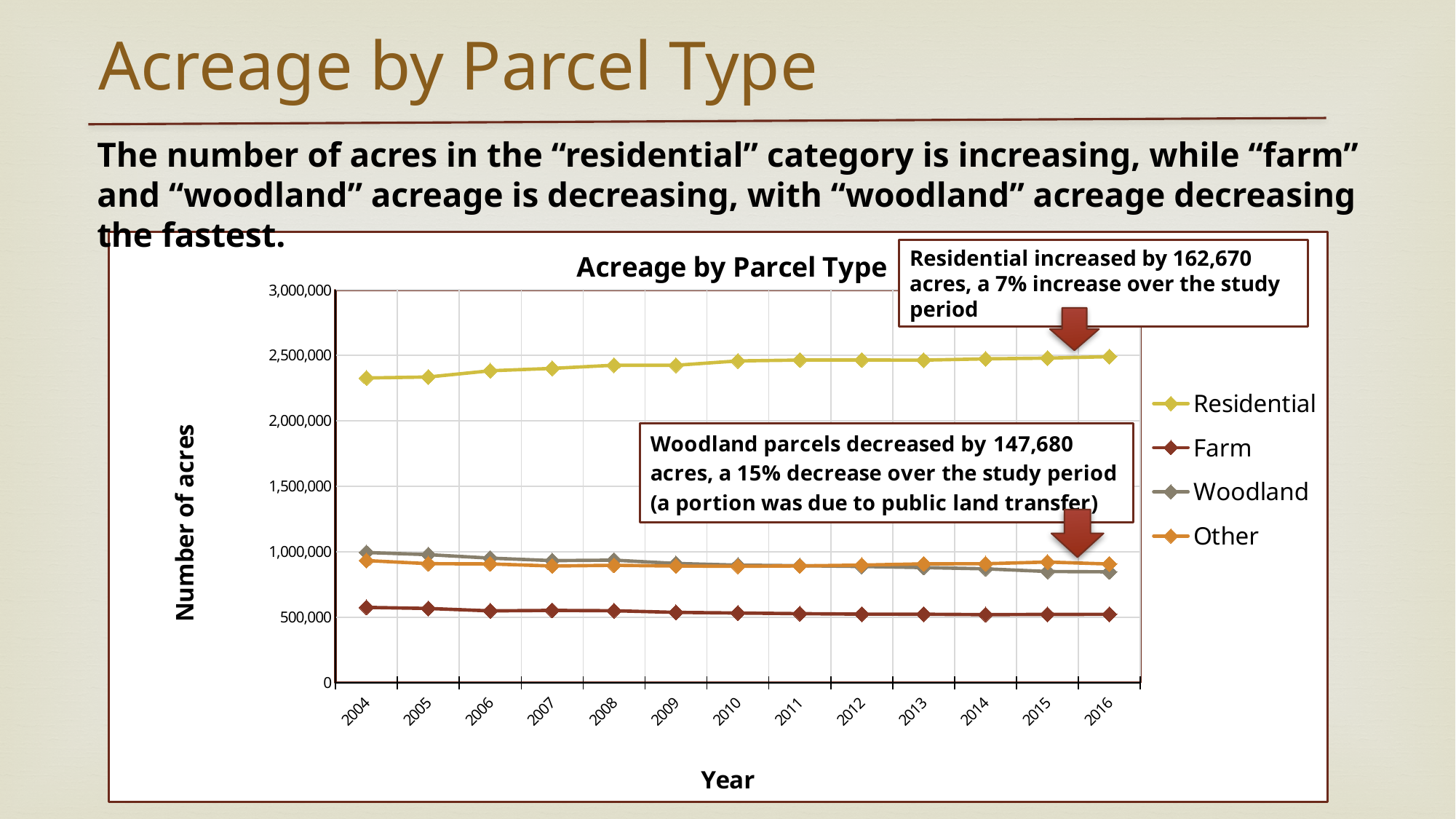
Is the value for Residential in 2004 greater or less than 2,000,000? greater In 2010, which is larger, the Woodland value or the Farm value? Woodland Is the value for Woodland in 2016 greater or less than 1,000,000? less Does the Woodland line rise or fall from 2004 to 2016? fall What kind of chart is shown on the slide? line chart Which parcel type has the lowest acreage throughout the chart? Farm How many series does the legend of the chart list? 4 Which parcel type has the highest acreage throughout the chart? Residential Does the Residential line rise or fall from 2004 to 2016? rise According to the annotation on the chart, by how many acres did Residential increase over the study period? 162,670 What is the label on the y axis of the chart? Number of acres How many years are plotted along the x axis of the chart? 13